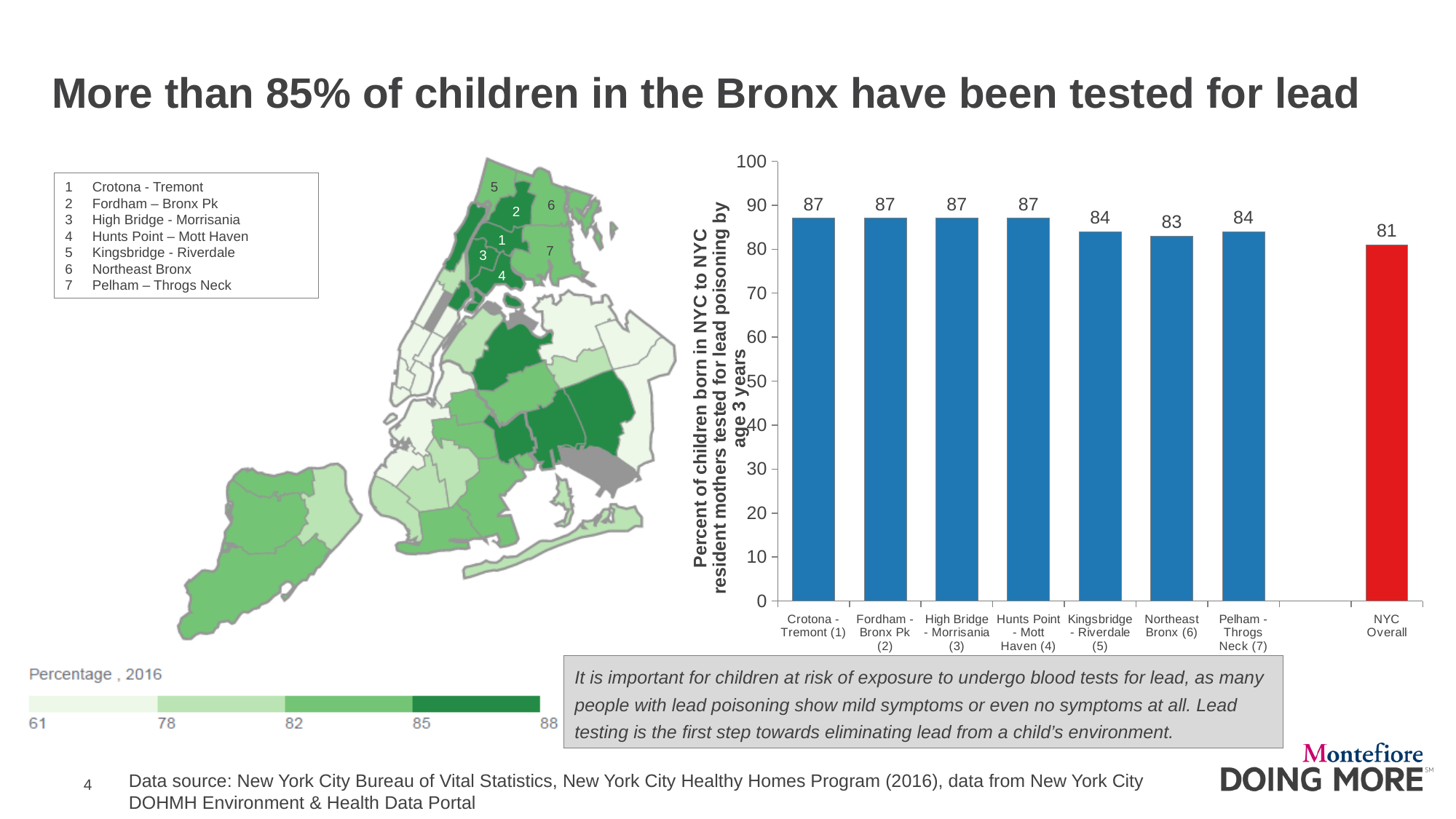
What is the difference between the values for Pelham - Throgs Neck (7) and Northeast Bronx (6)? 1 Which is larger, the value for Northeast Bronx (6) or the value for NYC Overall? Northeast Bronx (6) What is the difference between the values for Hunts Point - Mott Haven (4) and NYC Overall? 6 What is the value for Kingsbridge - Riverdale (5) in the bar chart? 84 What is the value for NYC Overall in the bar chart? 81 Which category has the lowest value in the bar chart? NYC Overall What colour is the NYC Overall bar in the bar chart? red How many bars are shown in the bar chart? 8 What is the value for Northeast Bronx (6) in the bar chart? 83 What kind of chart is shown on the right side of the slide? bar chart What is the value for Crotona - Tremont (1) in the bar chart? 87 Is the value for Fordham - Bronx Pk (2) greater or less than 80? greater